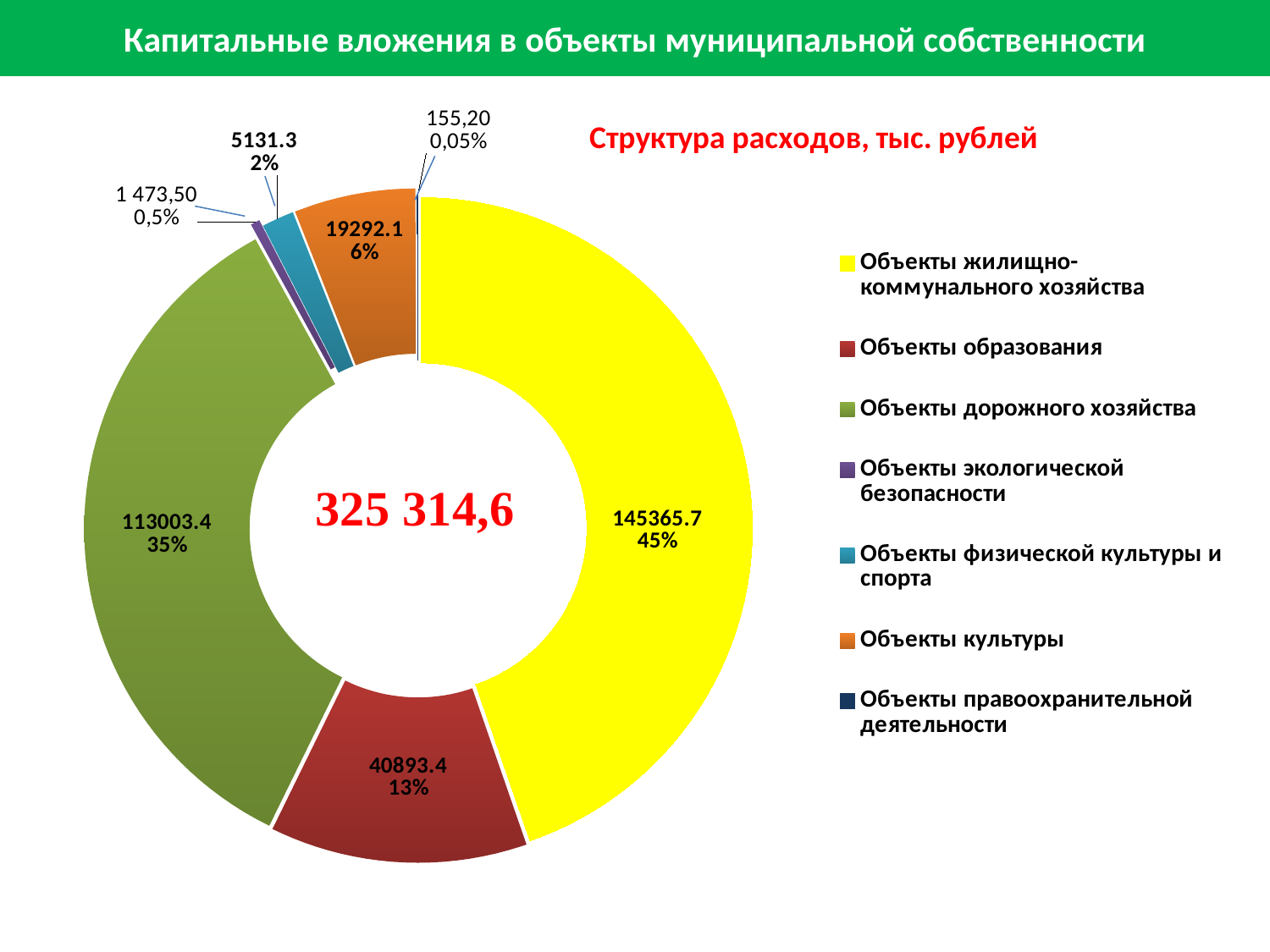
What is the value shown for Объекты образования? 40893.4 Which category has the smallest share of the chart? Объекты правоохранительной деятельности What total value is printed in the centre of the chart? 325 314,6 Which is larger: the value for Объекты дорожного хозяйства or the value for Объекты образования? Объекты дорожного хозяйства What kind of chart is shown on the slide? Doughnut (pie) chart What percentage share is shown for Объекты физической культуры и спорта? 2% What percentage share is shown for Объекты дорожного хозяйства? 35% Which category has the largest share of the chart? Объекты жилищно-коммунального хозяйства How many categories does the legend list? 7 What is the value shown for Объекты культуры? 19292.1 What is the value shown for Объекты жилищно-коммунального хозяйства? 145365.7 What is the value shown for Объекты экологической безопасности? 1 473,50